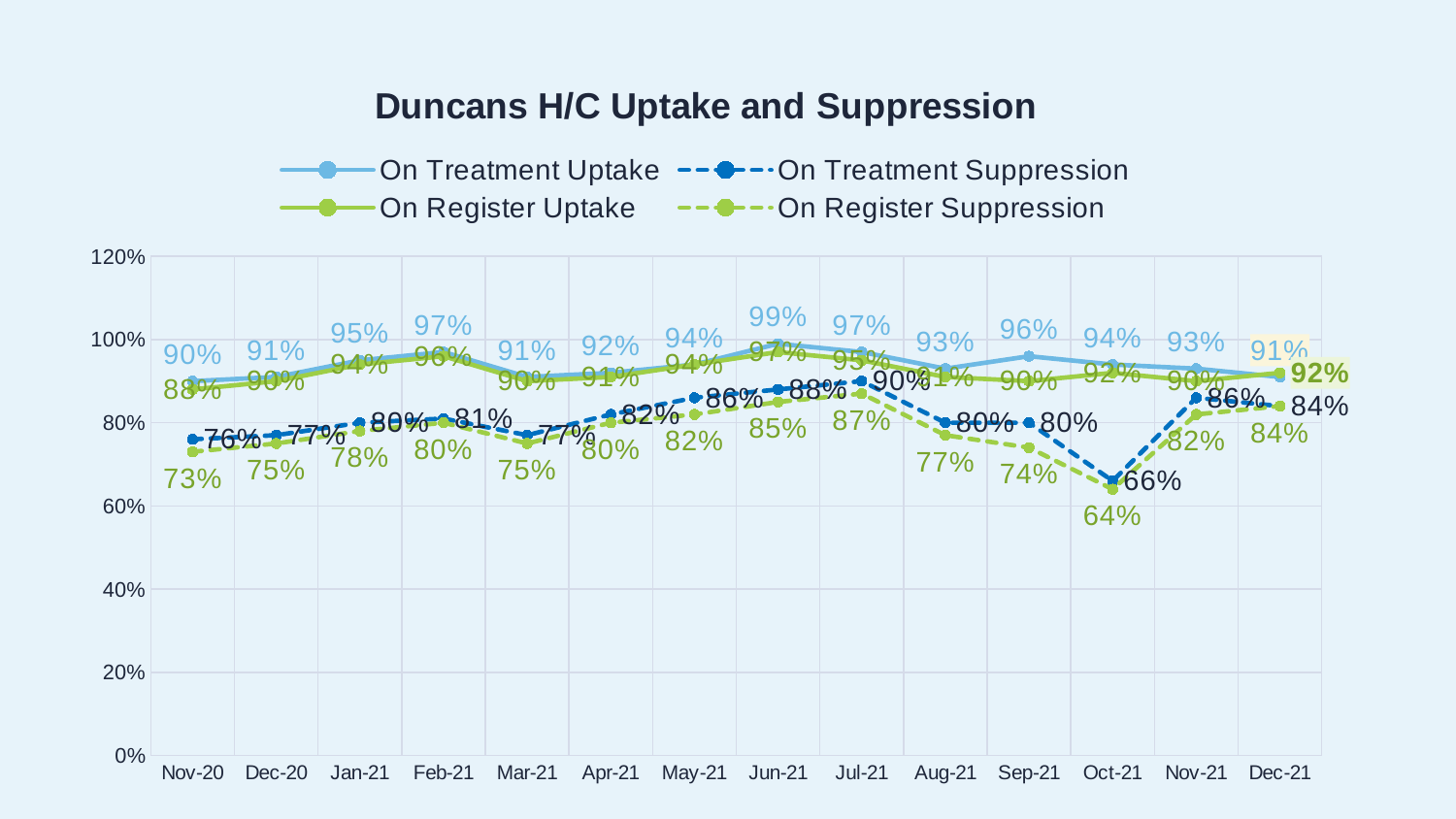
How many months are shown on the x axis? 14 How many series does the legend list? 4 What kind of chart is this? Line chart Which is larger in Sep-21: On Treatment Uptake or On Register Uptake? On Treatment Uptake What is the On Register Uptake value for Dec-21? 92% In which month is On Treatment Suppression lowest? Oct-21 What is the title of the chart? Duncans H/C Uptake and Suppression What is the On Register Suppression value for Oct-21? 64% What is the On Treatment Suppression value for Nov-20? 76% What is the On Treatment Uptake value for Jun-21? 99% What is the difference between On Treatment Suppression and On Register Suppression in Oct-21? 2% In which month is On Treatment Uptake highest? Jun-21